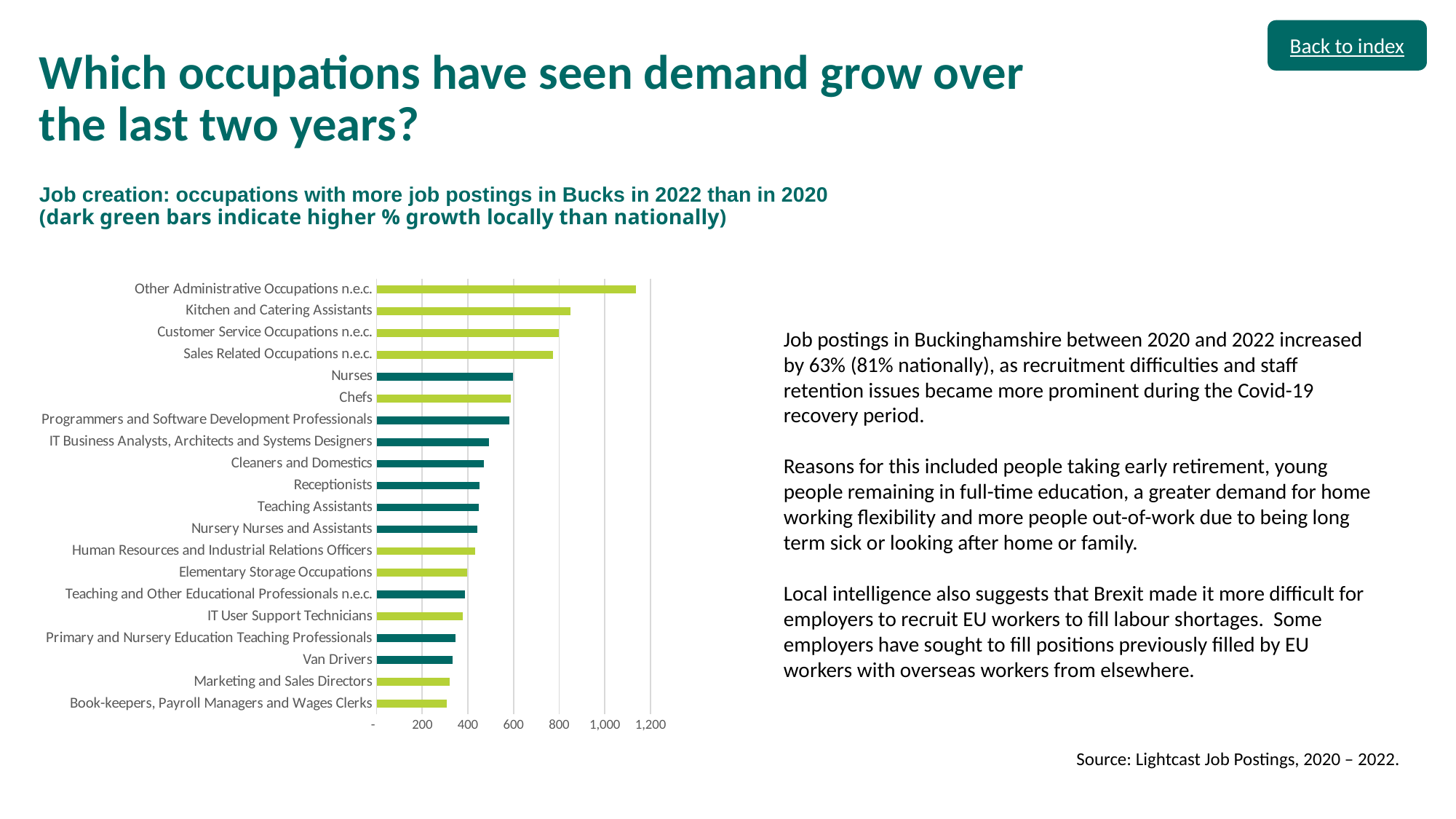
Is the value for Kitchen and Catering Assistants greater or less than 800? greater Is the value for Cleaners and Domestics greater or less than 600? less Is the value for Other Administrative Occupations n.e.c. greater or less than 1,000? greater What colour is the bar for Nurses? Dark green Which occupation has the highest number of job postings in the chart? Other Administrative Occupations n.e.c. Which has the larger value: Kitchen and Catering Assistants or Nurses? Kitchen and Catering Assistants According to the chart subtitle, what do the dark green bars indicate? Higher % growth locally than nationally Which has the larger value: Van Drivers or Customer Service Occupations n.e.c.? Customer Service Occupations n.e.c. How many occupations are plotted in the chart? 20 What kind of chart is shown on the slide? Bar chart